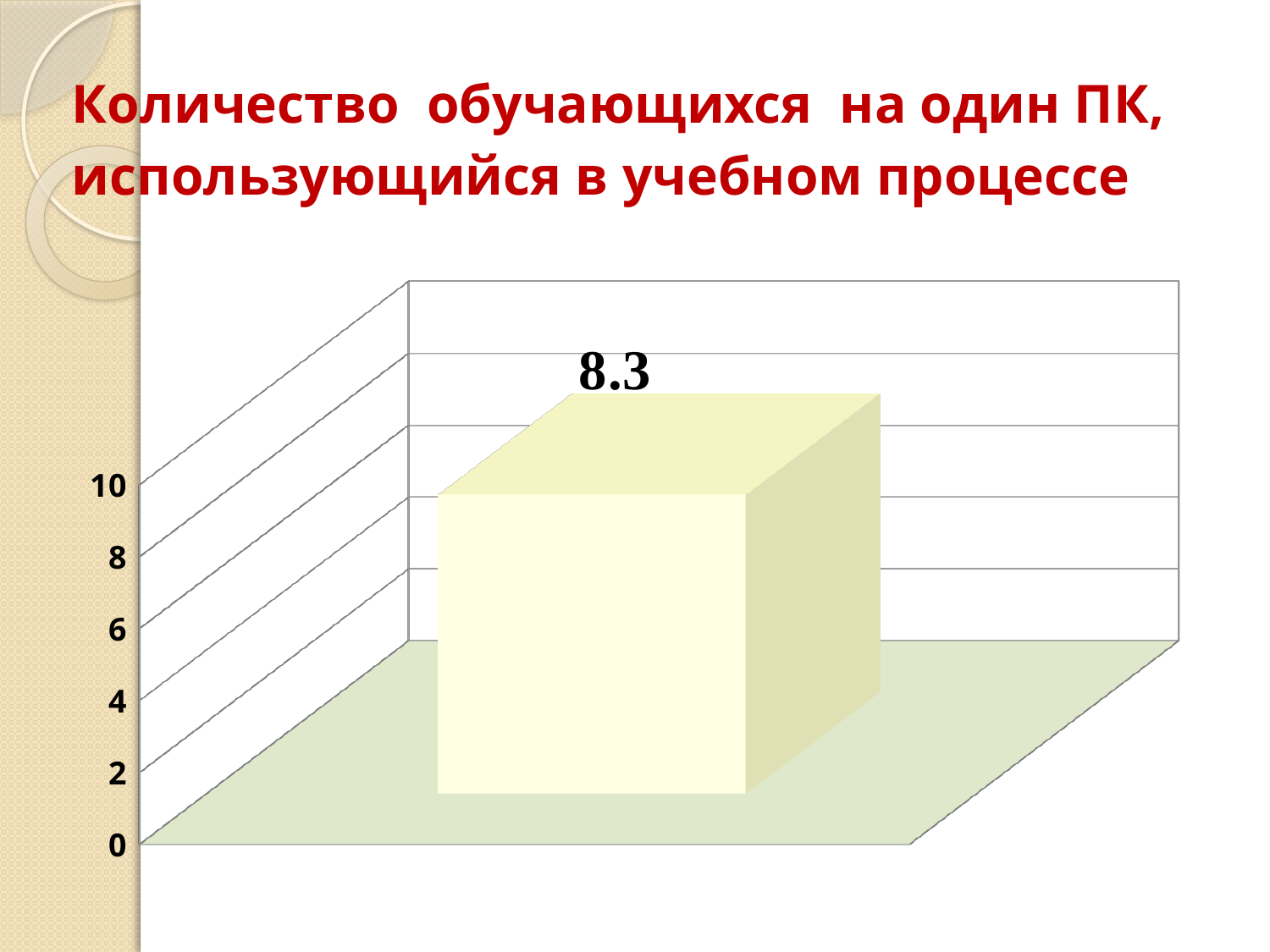
What is the title of the slide containing the chart? Количество обучающихся на один ПК, использующийся в учебном процессе Is the value of the bar greater or less than 6? greater How many bars are plotted in the chart? 1 What is the highest tick value shown on the vertical axis? 10 What kind of chart is shown on the slide? bar chart Is the value of the bar greater or less than 10? less What value is printed as the data label on the bar? 8.3